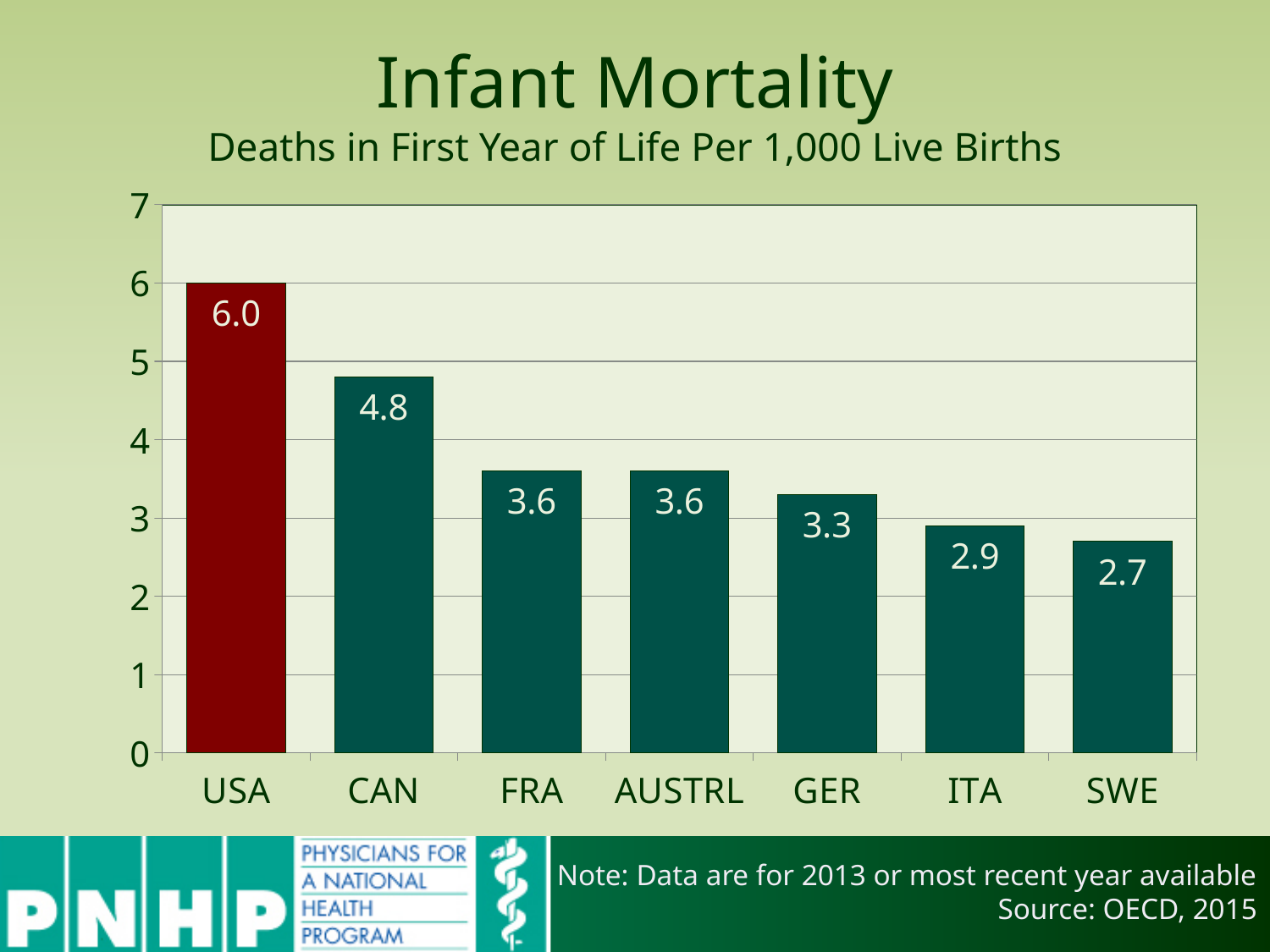
What is the infant mortality value for CAN? 4.8 What is the infant mortality value for USA? 6.0 Which country has the lowest infant mortality? SWE What is the infant mortality value for GER? 3.3 What kind of chart is this? Bar chart Which bar is coloured differently from the others? USA Which country has the highest infant mortality? USA What is the difference between the USA and CAN values? 1.2 What is the infant mortality value for SWE? 2.7 How many countries are shown on the chart? 7 What is the difference between the USA and SWE values? 3.3 Which is larger, the value for GER or the value for ITA? GER